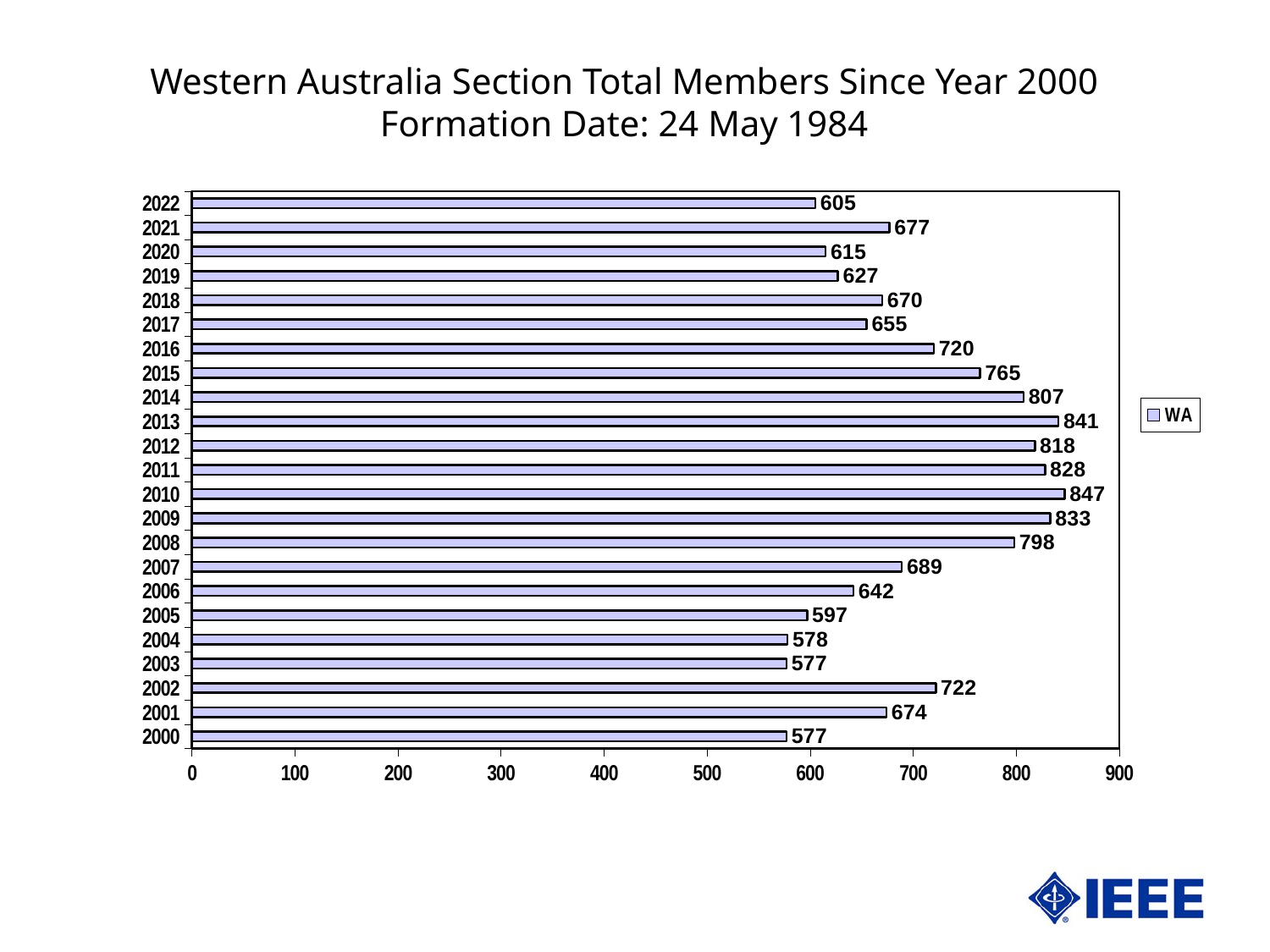
Which year had more members, 2016 or 2021? 2016 Which year had the highest number of members? 2010 How many years are shown on the chart? 23 What is the difference in members between 2013 and 2014? 34 What was the total number of WA members in 2002? 722 How many series does the legend list? 1 What was the total number of WA members in 2010? 847 What was the total number of WA members in 2022? 605 What kind of chart is shown on the slide? Bar chart What is the name of the series shown in the legend? WA Which year had the lowest number of members? 2000 and 2003 Is the value for 2008 greater or less than 700? greater